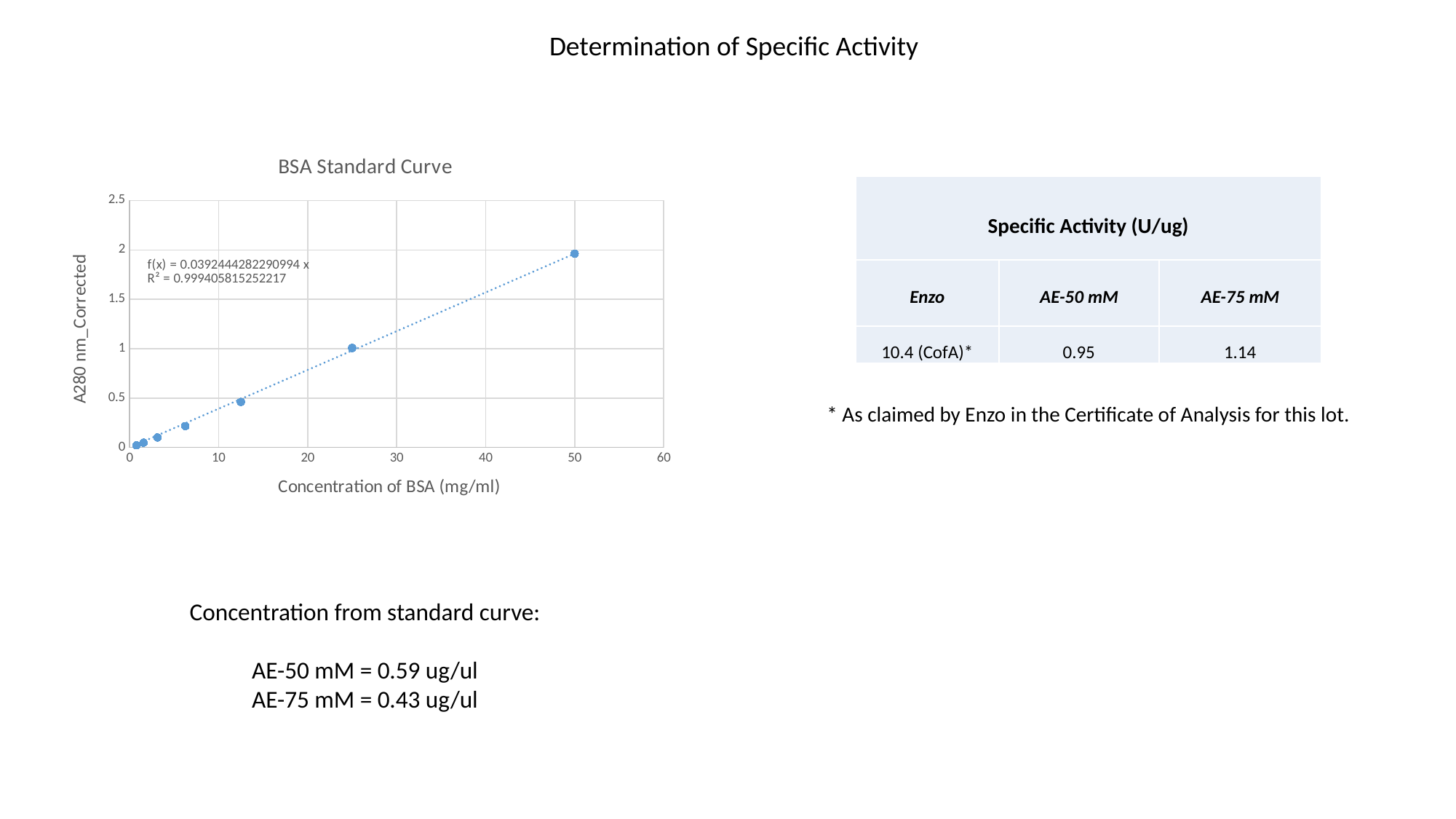
Is the A280 nm_Corrected value at a BSA concentration of 50 mg/ml greater or less than 1.5? greater Which plotted point has the highest A280 nm_Corrected value, the one at 50 mg/ml or the one at 25 mg/ml? 50 mg/ml What R² value is printed on the BSA Standard Curve chart? 0.999405815252217 What is the maximum value shown on the y axis of the BSA Standard Curve? 2.5 How many data points are plotted on the BSA Standard Curve? 7 Is the A280 nm_Corrected value at a BSA concentration of 25 mg/ml greater or less than 0.5? greater Do the A280 nm_Corrected values rise or fall as the concentration of BSA increases? rise What kind of chart is the BSA Standard Curve? scatter chart What is the maximum value shown on the x axis of the BSA Standard Curve? 60 What is the title of the chart on the slide? BSA Standard Curve Is the A280 nm_Corrected value at a BSA concentration of 25 mg/ml greater or less than 1.5? less